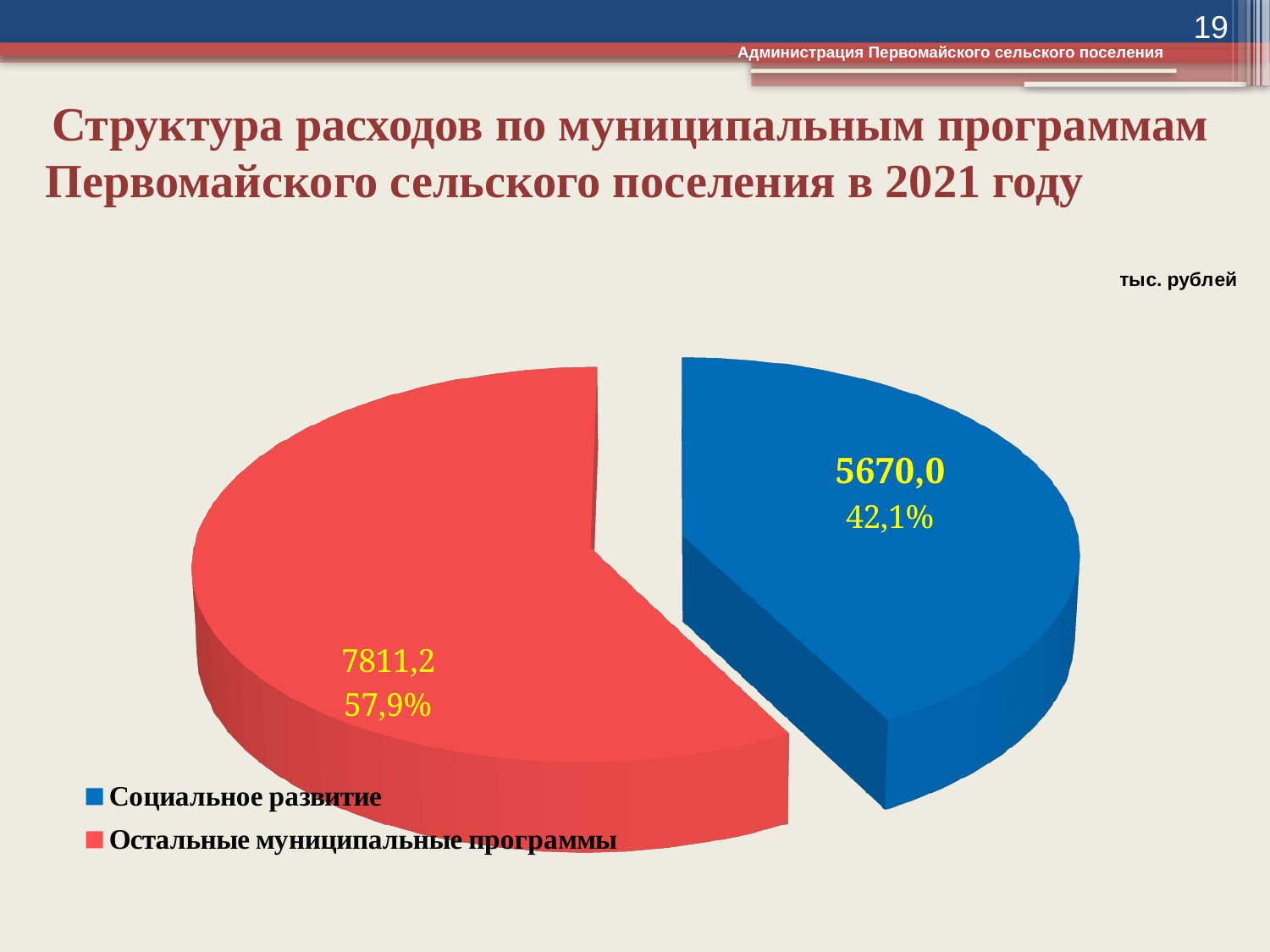
What is the value for Социальное развитие? 5670,0 What share of the pie does Остальные муниципальные программы represent? 57,9% Which is larger: Социальное развитие or Остальные муниципальные программы? Остальные муниципальные программы Which category has the smallest slice of the pie? Социальное развитие What is the value for Остальные муниципальные программы? 7811,2 What colour is the slice for Социальное развитие? Blue What is the total of the two values shown in the pie chart? 13481,2 What type of chart is shown on the slide? Pie chart Which category has the largest slice of the pie? Остальные муниципальные программы How many categories does the pie chart contain? 2 What is the difference between the values for Остальные муниципальные программы and Социальное развитие? 2141,2 What share of the pie does Социальное развитие represent? 42,1%